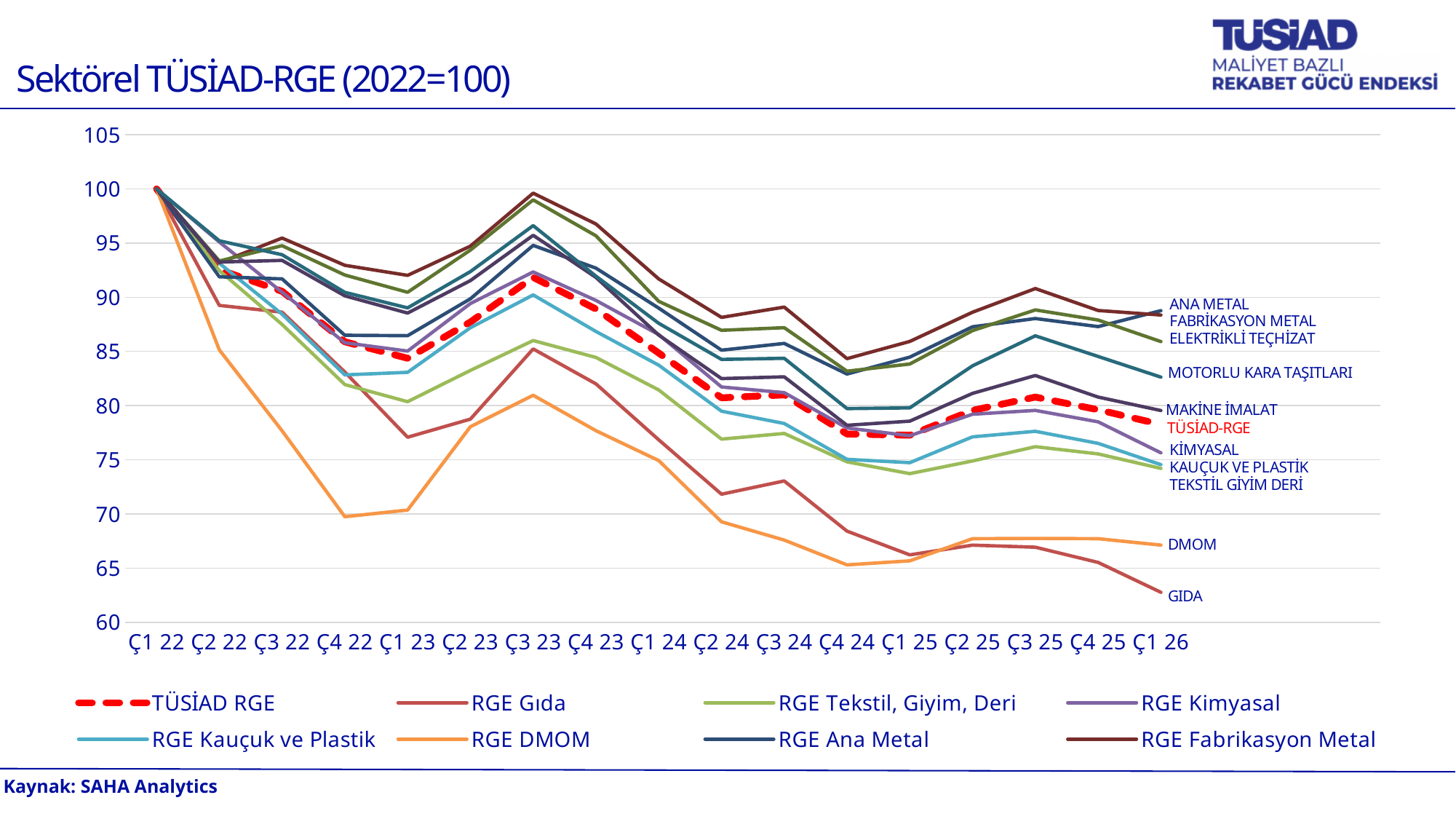
How many series does the legend list? 8 Which series has the lowest value at Ç4 22? RGE DMOM Is the value for RGE Gıda at Ç1 26 greater or less than 65? less Is the value for RGE Fabrikasyon Metal at Ç3 23 greater or less than 95? greater Which series has the lowest value at Ç1 26? RGE Gıda At Ç1 26, which is larger: RGE DMOM or RGE Gıda? RGE DMOM How many quarters are shown along the x axis? 17 What is the value of TÜSİAD RGE at Ç1 22? 100 Is the value for TÜSİAD RGE at Ç1 26 greater or less than 80? less What kind of chart is shown on the slide? line chart Does the TÜSİAD RGE line overall rise or fall from Ç1 22 to Ç1 26? fall